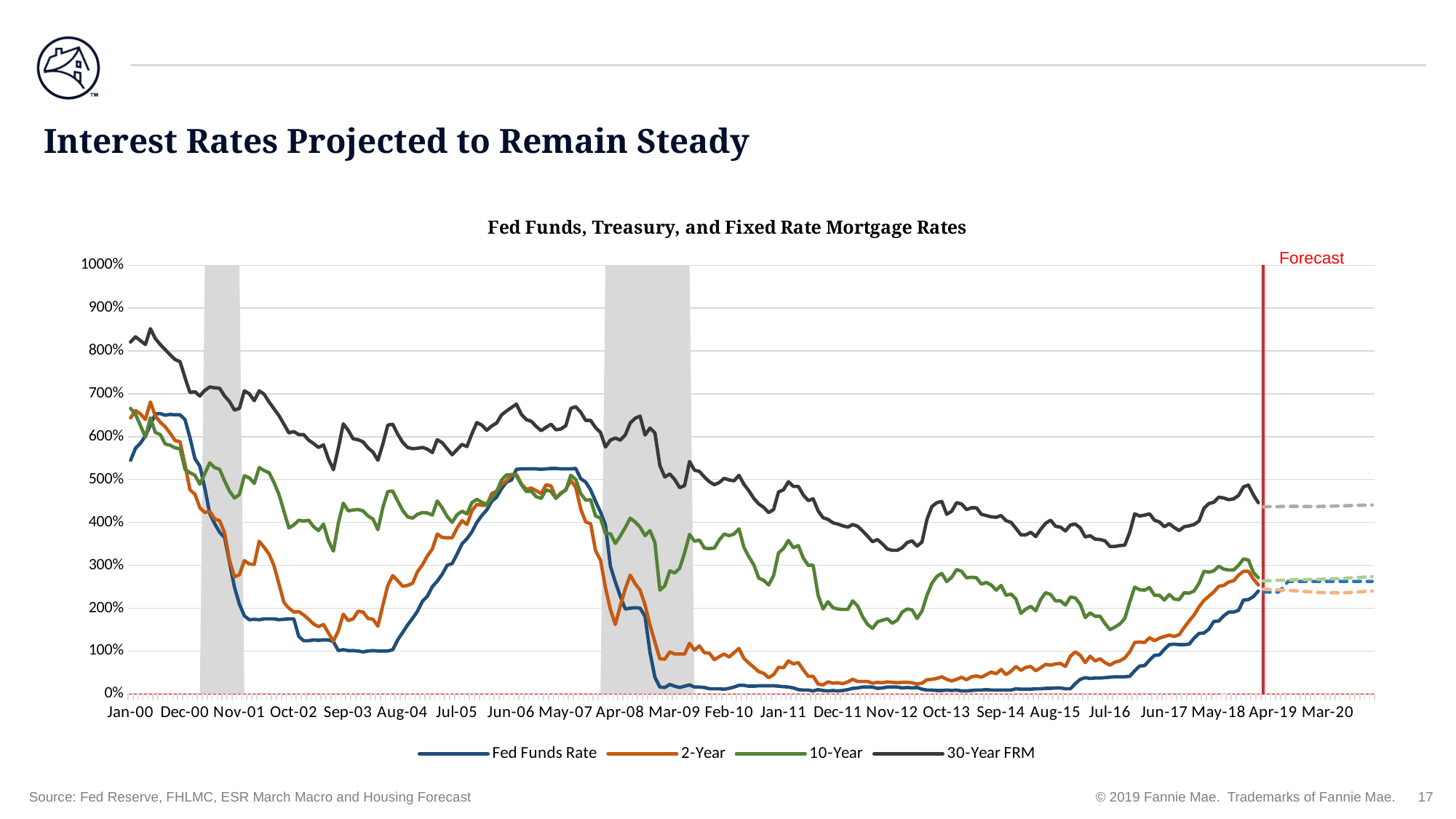
Does the Fed Funds Rate rise or fall between Jul-16 and Apr-19? rise What kind of chart is shown on the slide? line chart Is the value for the 10-Year at Apr-19 greater or less than 200%? greater What is the title of the chart? Fed Funds, Treasury, and Fixed Rate Mortgage Rates Which series has the highest value at Jan-00? 30-Year FRM How many series does the legend list? 4 Is the value for the 30-Year FRM at Jan-00 greater or less than 800%? greater Is the value for the Fed Funds Rate at Jan-11 greater or less than 100%? less Does the 30-Year FRM rise or fall between Jan-00 and Sep-03? fall Which series has the lowest value at Jan-11? Fed Funds Rate What does the red vertical line near Apr-19 mark? Forecast At Jan-00, which is larger: the 30-Year FRM or the Fed Funds Rate? 30-Year FRM